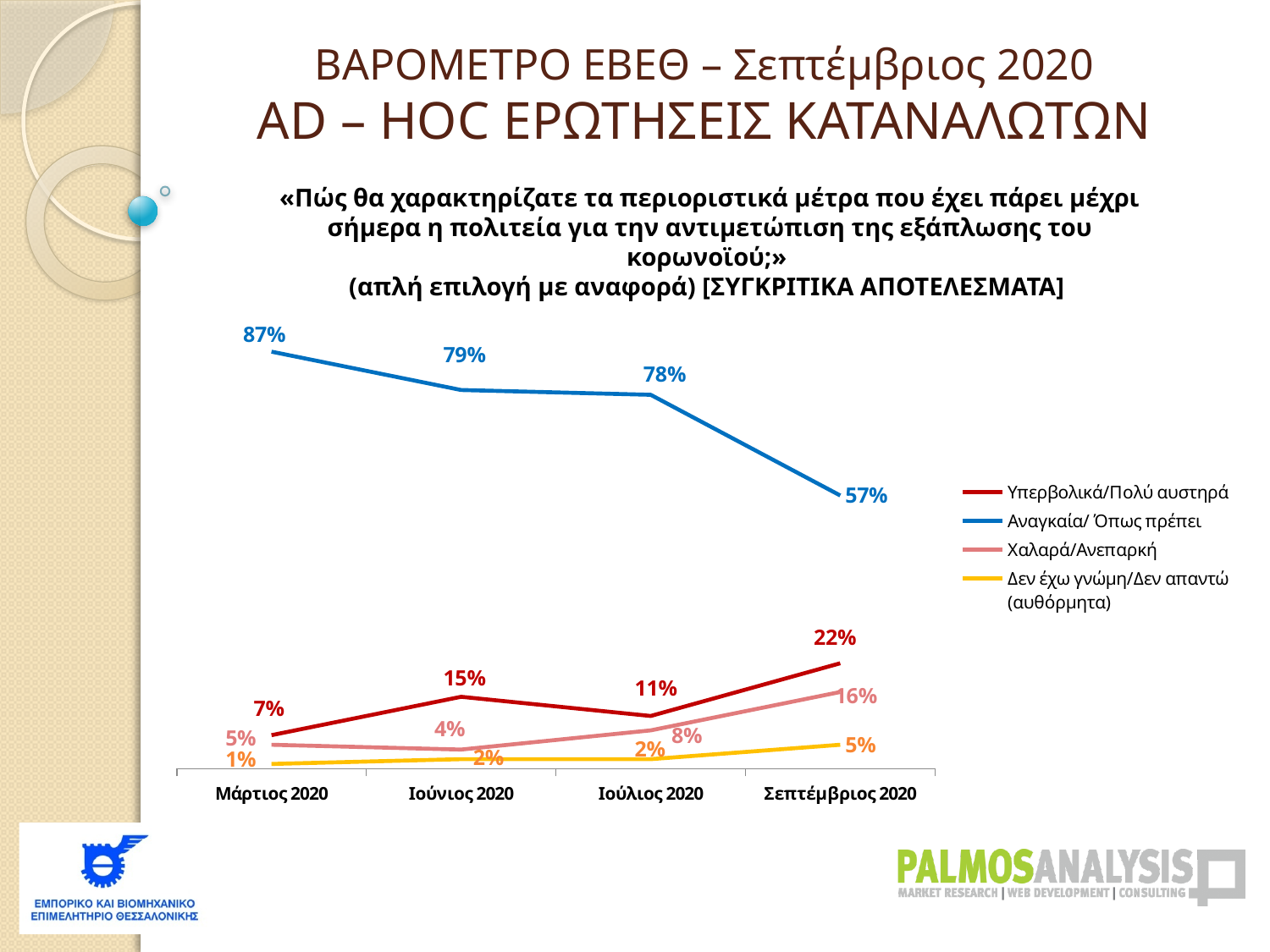
How many time points are shown on the x axis? 4 What is the difference between the Αναγκαία/Όπως πρέπει values in Ιούλιος 2020 and Σεπτέμβριος 2020? 21% What kind of chart is shown on the slide? Line chart In which time point is the value for Υπερβολικά/Πολύ αυστηρά highest? Σεπτέμβριος 2020 Does the Αναγκαία/Όπως πρέπει series rise or fall from Μάρτιος 2020 to Σεπτέμβριος 2020? Fall In which time point is the value for Αναγκαία/Όπως πρέπει lowest? Σεπτέμβριος 2020 What is the value for Υπερβολικά/Πολύ αυστηρά in Ιούνιος 2020? 15% What is the value for Χαλαρά/Ανεπαρκή in Σεπτέμβριος 2020? 16% What is the value for Αναγκαία/Όπως πρέπει in Σεπτέμβριος 2020? 57% What is the value for Αναγκαία/Όπως πρέπει in Μάρτιος 2020? 87% How many series does the legend list? 4 What is the value for Δεν έχω γνώμη/Δεν απαντώ (αυθόρμητα) in Μάρτιος 2020? 1%